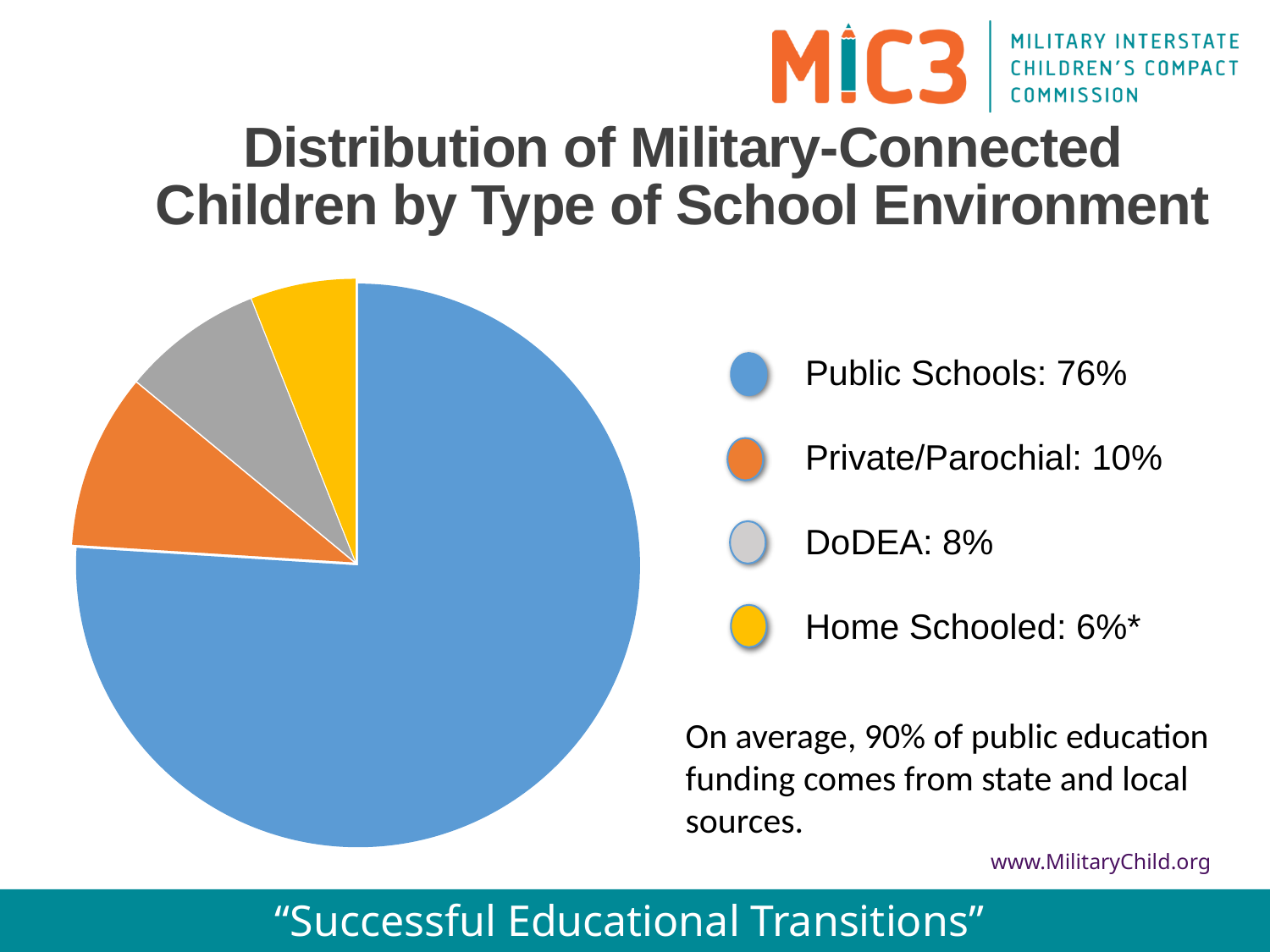
What kind of chart is shown on the slide? Pie chart What share of military-connected children attend Public Schools? 76% What colour represents Public Schools in the pie chart? Blue What share of military-connected children are Home Schooled? 6% Which school environment has the largest share of military-connected children? Public Schools How many school environment categories does the pie chart show? 4 Which is larger, the share for DoDEA or the share for Home Schooled? DoDEA What is the title of the chart? Distribution of Military-Connected Children by Type of School Environment Which school environment has the smallest share of military-connected children? Home Schooled What is the difference in percentage points between Public Schools and Private/Parochial? 66 What share of military-connected children attend DoDEA schools? 8% What share of military-connected children attend Private/Parochial schools? 10%